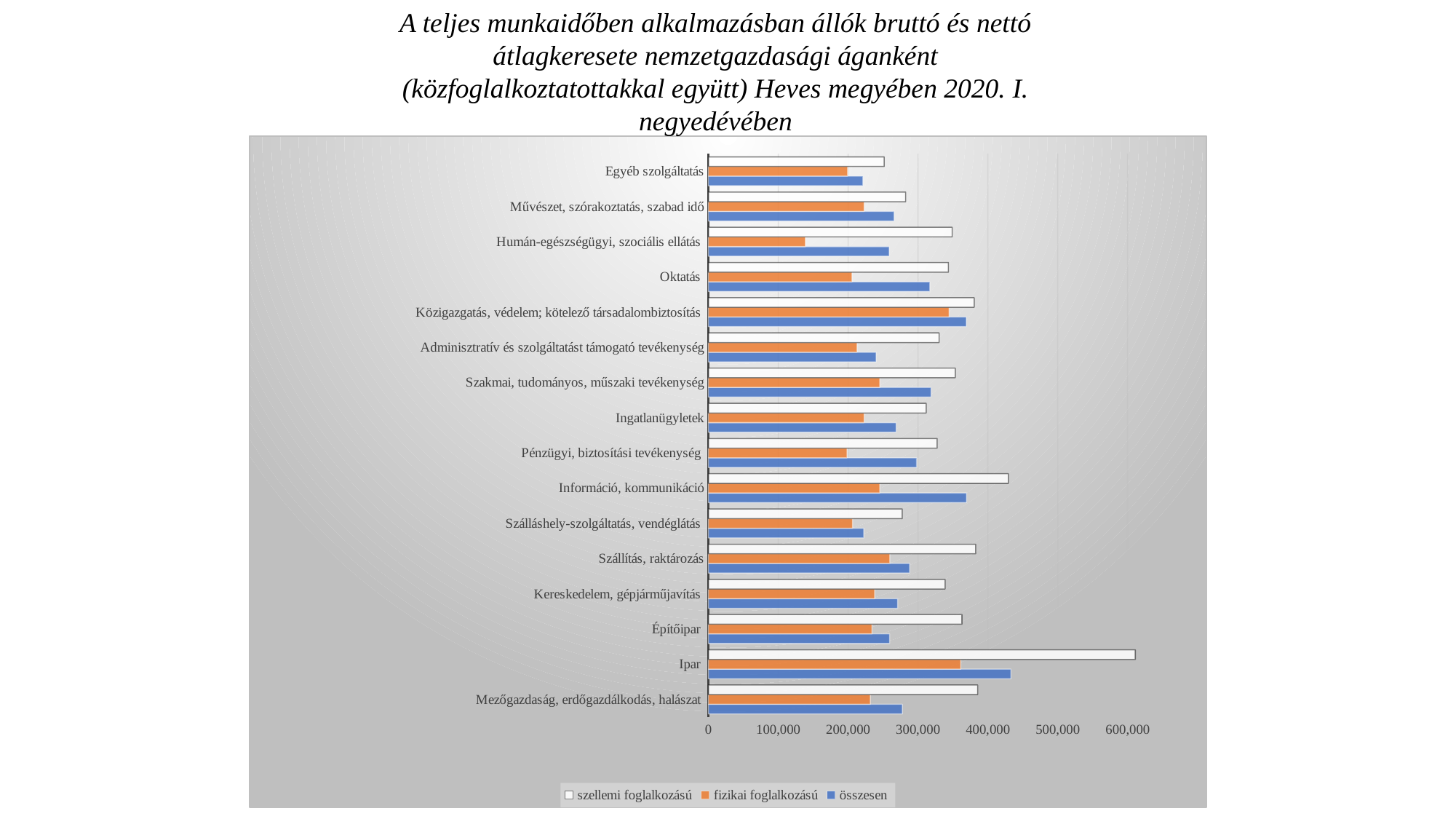
Is the 'szellemi foglalkozású' value for Információ, kommunikáció greater or less than 400,000? greater Which sector has the lowest value for the 'fizikai foglalkozású' series? Humán-egészségügyi, szociális ellátás Which sector has the highest value for the 'összesen' series? Ipar What kind of chart is shown on the slide? bar chart Which is larger for Humán-egészségügyi, szociális ellátás: the 'szellemi foglalkozású' value or the 'fizikai foglalkozású' value? szellemi foglalkozású Is the 'szellemi foglalkozású' value for Ipar greater or less than 500,000? greater Is the 'fizikai foglalkozású' value for Humán-egészségügyi, szociális ellátás greater or less than 200,000? less How many economic sectors (categories) are shown on the chart? 16 Which sector has the larger 'fizikai foglalkozású' value: Közigazgatás, védelem; kötelező társadalombiztosítás or Oktatás? Közigazgatás, védelem; kötelező társadalombiztosítás How many series does the legend list? 3 Which sector has the highest value for the 'szellemi foglalkozású' series? Ipar What colour represents the 'összesen' series in the legend? blue